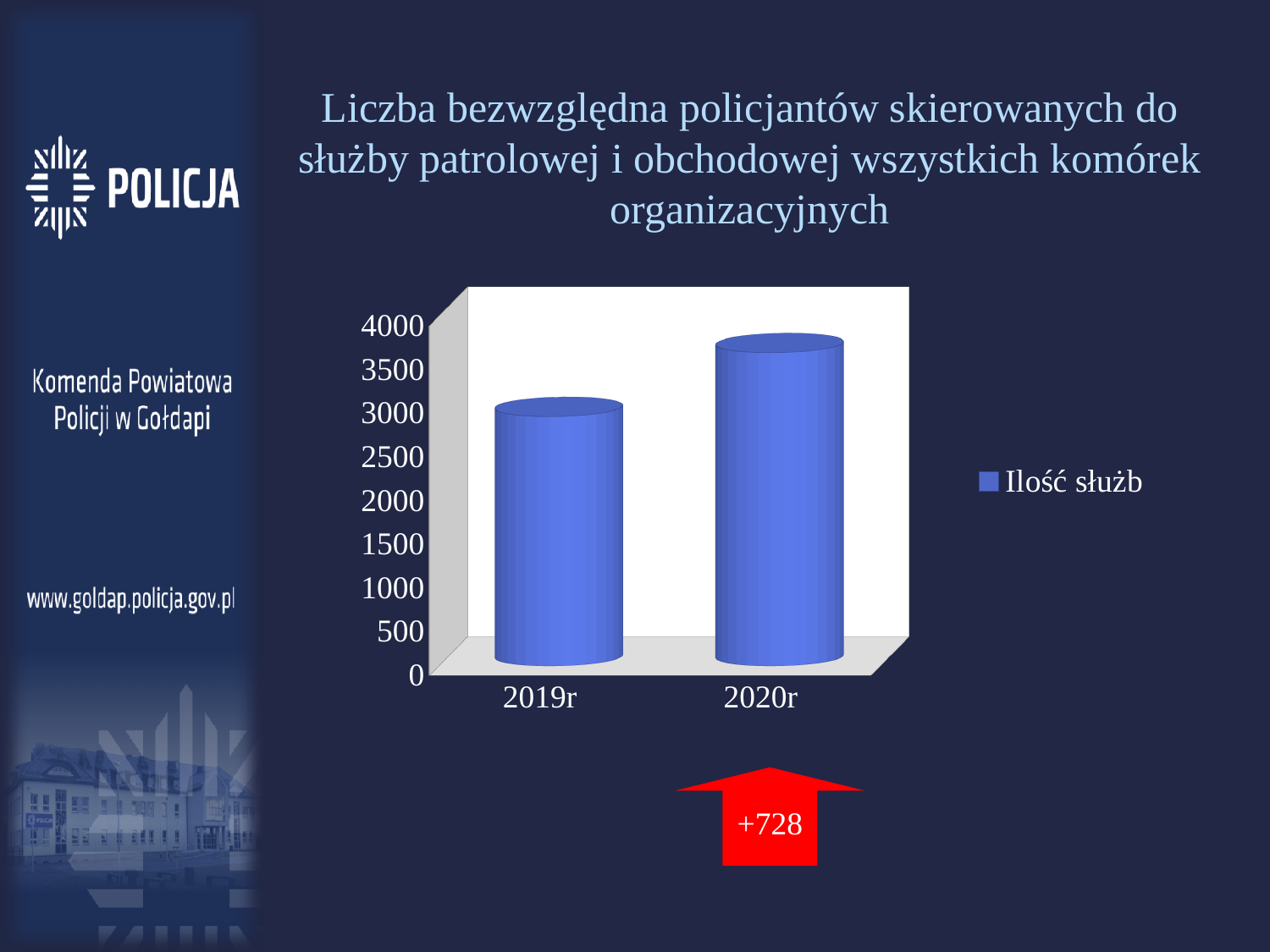
Do the values rise or fall from 2019r to 2020r? rise Is the value for 2020r greater or less than 4000? less Is the value for 2019r greater or less than 2500? greater What is the name of the series listed in the chart's legend? Ilość służb What change from 2019r to 2020r is indicated by the red arrow below the chart? +728 Which year has the lowest value in the chart? 2019r Which year has the highest value in the chart? 2020r Which is larger, the value for 2019r or the value for 2020r? 2020r What kind of chart is shown on the slide? bar chart How many categories are shown on the x axis of the chart? 2 How many series does the chart's legend list? 1